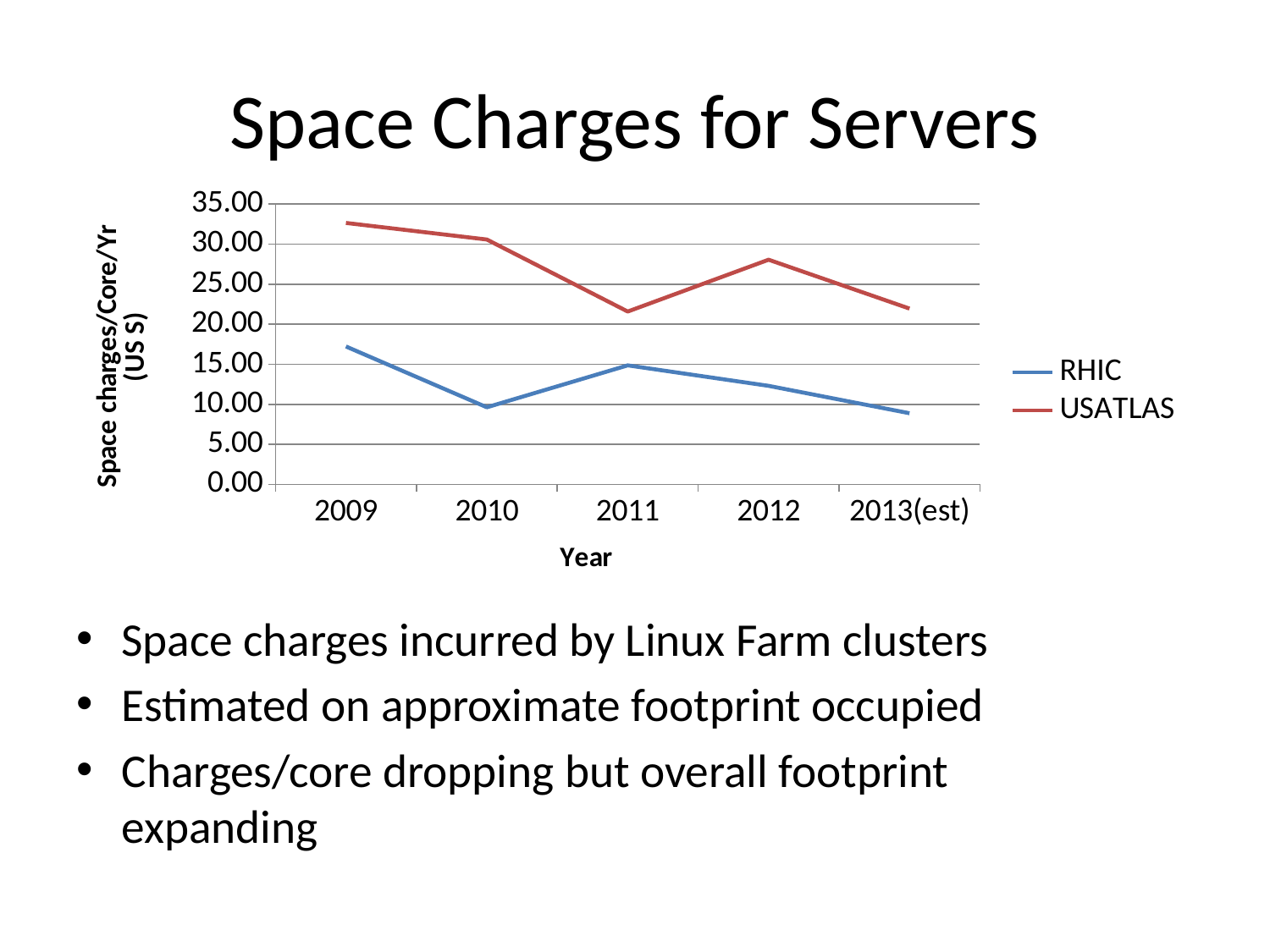
In which year is the USATLAS value highest? 2009 Is the value for USATLAS in 2009 greater or less than 30.00? greater Is the value for RHIC in 2012 greater or less than 10.00? greater What kind of chart is shown on the slide? line chart Which series has the larger value in 2011, RHIC or USATLAS? USATLAS How many series does the legend list? 2 In which year is the RHIC value highest? 2009 Does the USATLAS line overall rise or fall from 2009 to 2013(est)? fall Is the value for USATLAS in 2011 greater or less than 25.00? less How many years are plotted along the x axis? 5 What is the title of the y axis? Space charges/Core/Yr (US $)